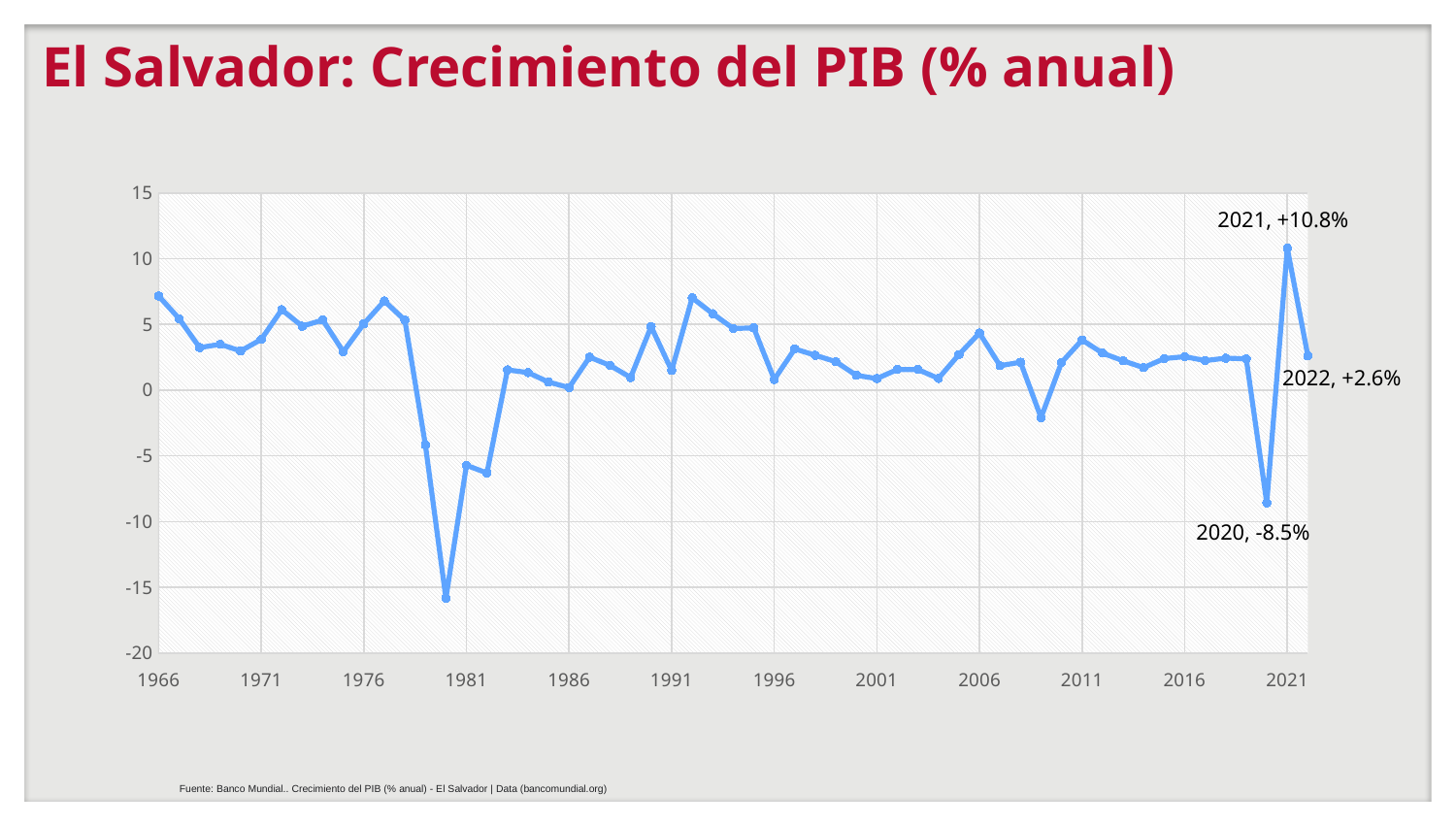
What is the difference between the labelled values for 2021 and 2022? 8.2 percentage points What is the title of the chart on the slide? El Salvador: Crecimiento del PIB (% anual) What kind of chart is shown on the slide? Line chart What is the GDP growth value labelled for 2022? +2.6% Which is larger, the GDP growth value for 2021 or for 2022? 2021 Which year has the highest GDP growth value on the chart? 2021 What is the GDP growth value labelled for 2021? +10.8% What is the GDP growth value labelled for 2020? -8.5% Does the value rise or fall from 2020 to 2021? rise Is the lowest value on the chart greater or less than -10? less What is the difference between the labelled values for 2021 and 2020? 19.3 percentage points Is the value for 1966 greater or less than 5? greater